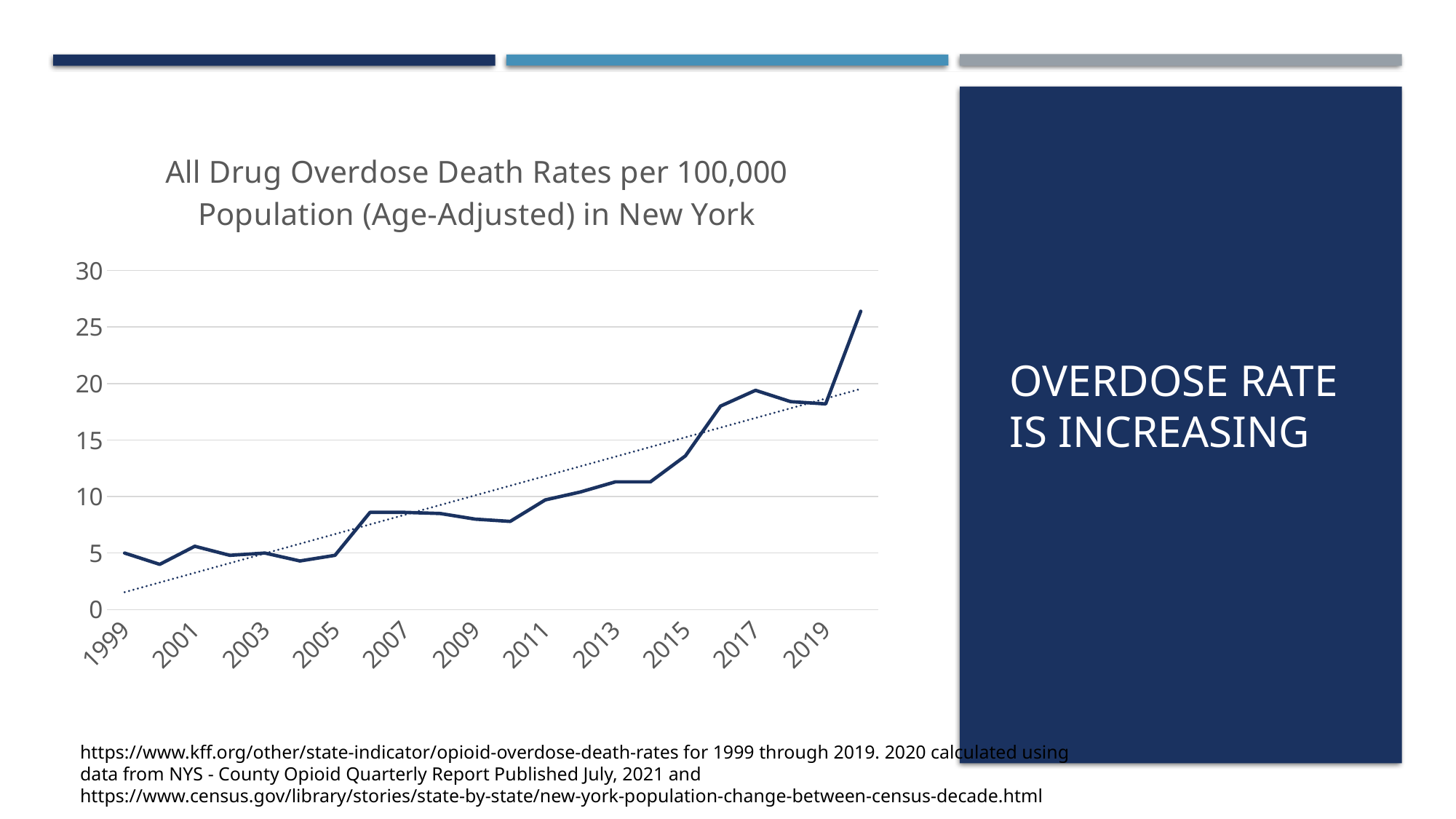
Do the overdose death rates generally rise or fall from 1999 to the end of the series? rise Is the value for 2017 greater or less than 15? greater Is the value for 2013 greater or less than 10? greater What kind of chart is shown on the slide? line chart Is the value for 2015 greater or less than 15? less Which year has the larger overdose death rate, 2009 or 2017? 2017 Which year has the highest overdose death rate on the chart? 2020 What is the title of the chart? All Drug Overdose Death Rates per 100,000 Population (Age-Adjusted) in New York How many year labels are shown on the x axis? 11